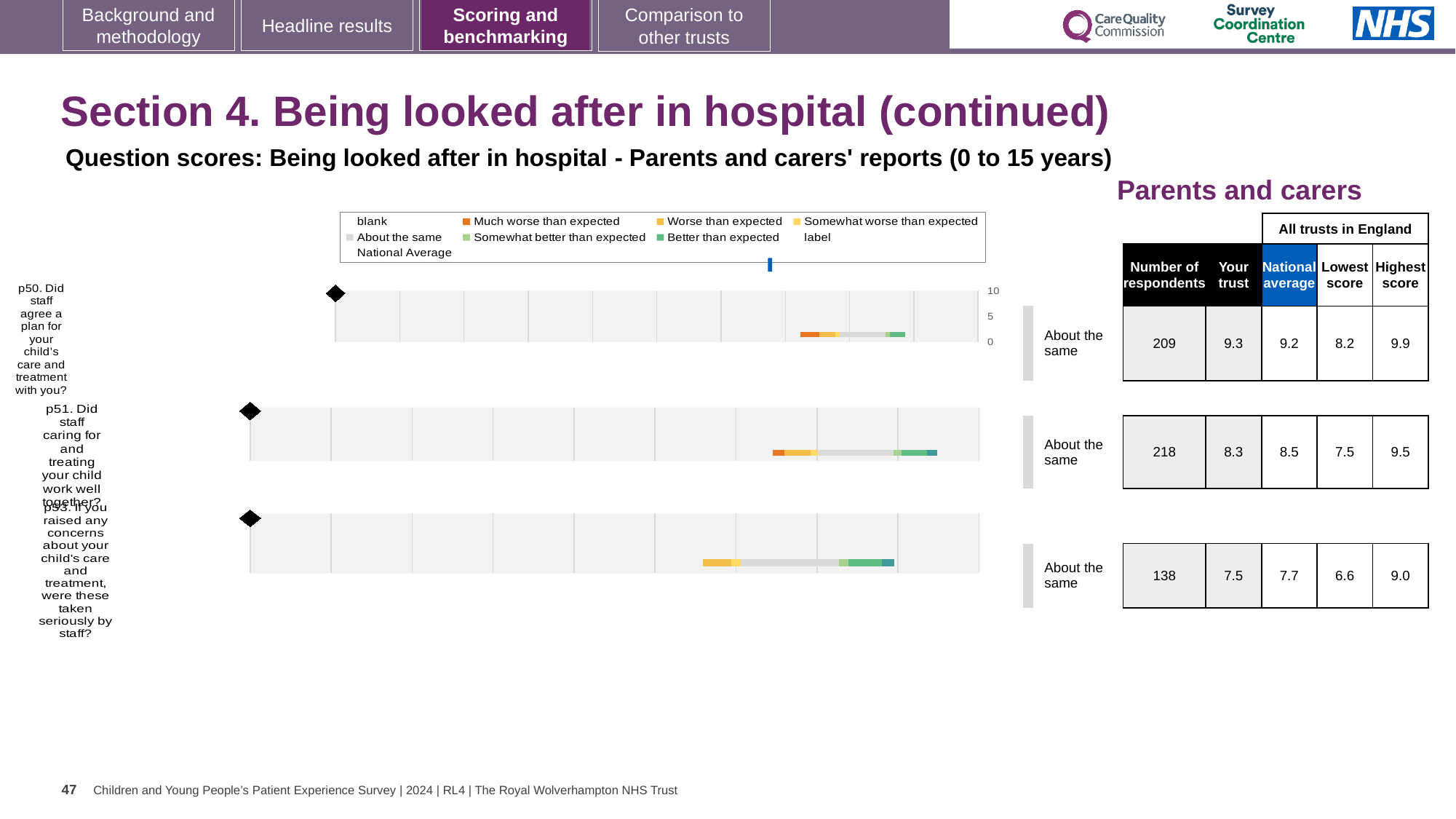
How many questions (charts) are plotted on the slide? 3 What tick values are shown on the axis of the first chart (p50)? 0, 5, 10 Which question has the highest Your trust score? p50 What kind of chart is used to show the benchmarking for p50? bar chart Which question has the fewest respondents? p53 How many entries does the legend above the charts list? 9 For p53, is the Your trust score higher or lower than the National average? lower For p50, what is the difference between the Highest score and the Lowest score in the table? 1.7 What benchmark label is shown to the right of each of the three charts? About the same In the table, what is the Your trust score for p51 (Did staff caring for and treating your child work well together)? 8.3 In the table, what is the number of respondents for p50 (Did staff agree a plan for your child's care and treatment with you)? 209 In the table, what is the National average score for p51? 8.5